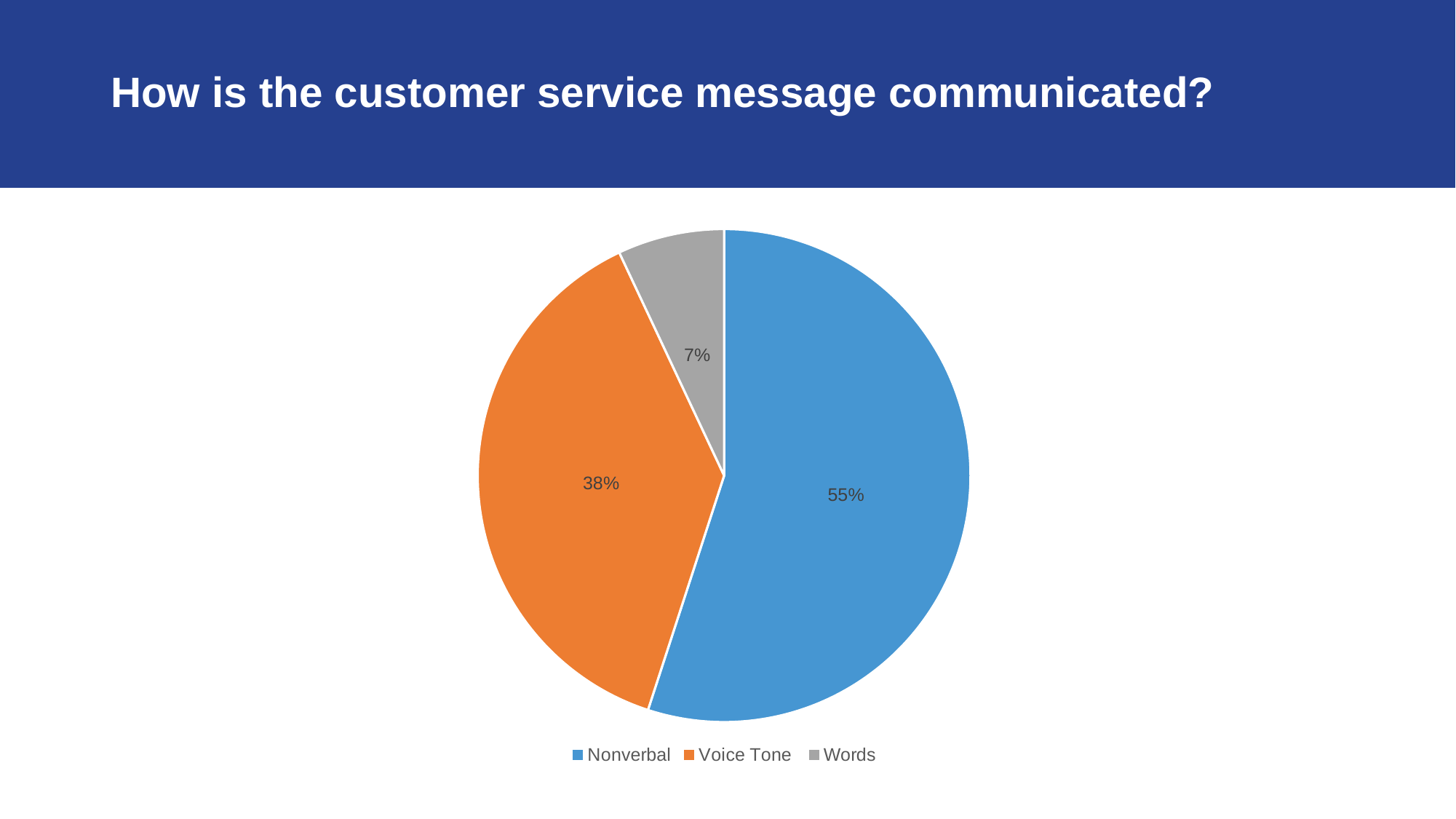
What share of the pie does Voice Tone account for? 38% What kind of chart is shown on the slide? pie chart How many categories does the pie chart show? 3 What colour is the Voice Tone slice? orange What is the difference in percentage points between Nonverbal and Voice Tone? 17 Which is larger, the Voice Tone slice or the Words slice? Voice Tone What is the difference in percentage points between Voice Tone and Words? 31 Which category has the largest slice of the pie? Nonverbal What share of the pie does Words account for? 7% Which category has the smallest slice of the pie? Words What share of the pie does Nonverbal account for? 55% Which legend entry is shown in grey? Words